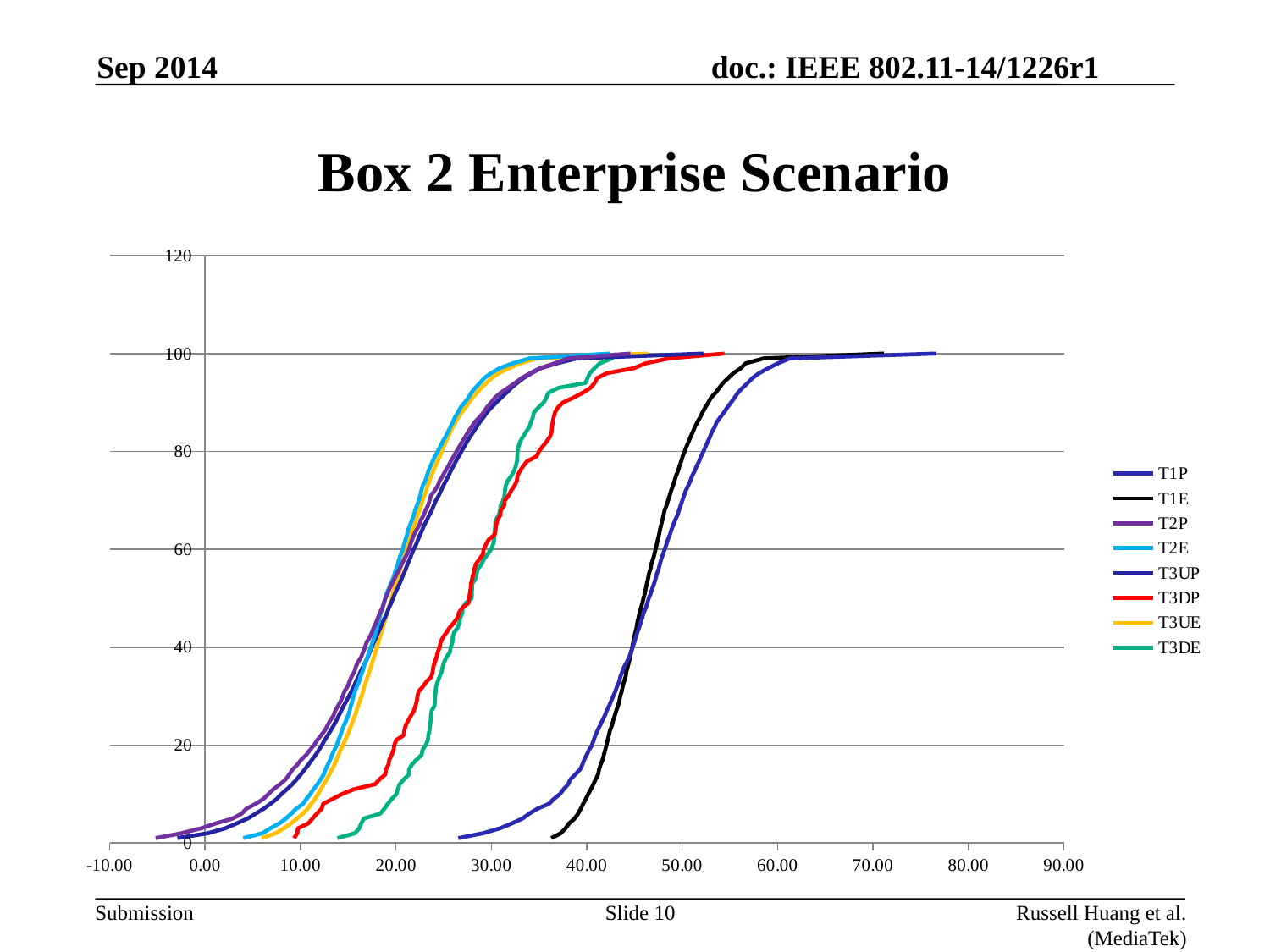
What kind of chart is shown on the slide? line chart Which series is drawn in red in the chart? T3DP What is the title of the chart? Box 2 Enterprise Scenario Is the value of T3DP at x = 40.00 greater or less than 80? greater How many series does the legend list? 8 At x = 30.00, which series has the larger value, T2E or T3DE? T2E Is the value of T3DE at x = 20.00 greater or less than 20? less Which series reaches its top value at the largest x value? T1P Is the value of T1P at x = 40.00 greater or less than 40? less Do the values of the series rise or fall as the x axis increases? rise Which series begins at the lowest x value? T2P